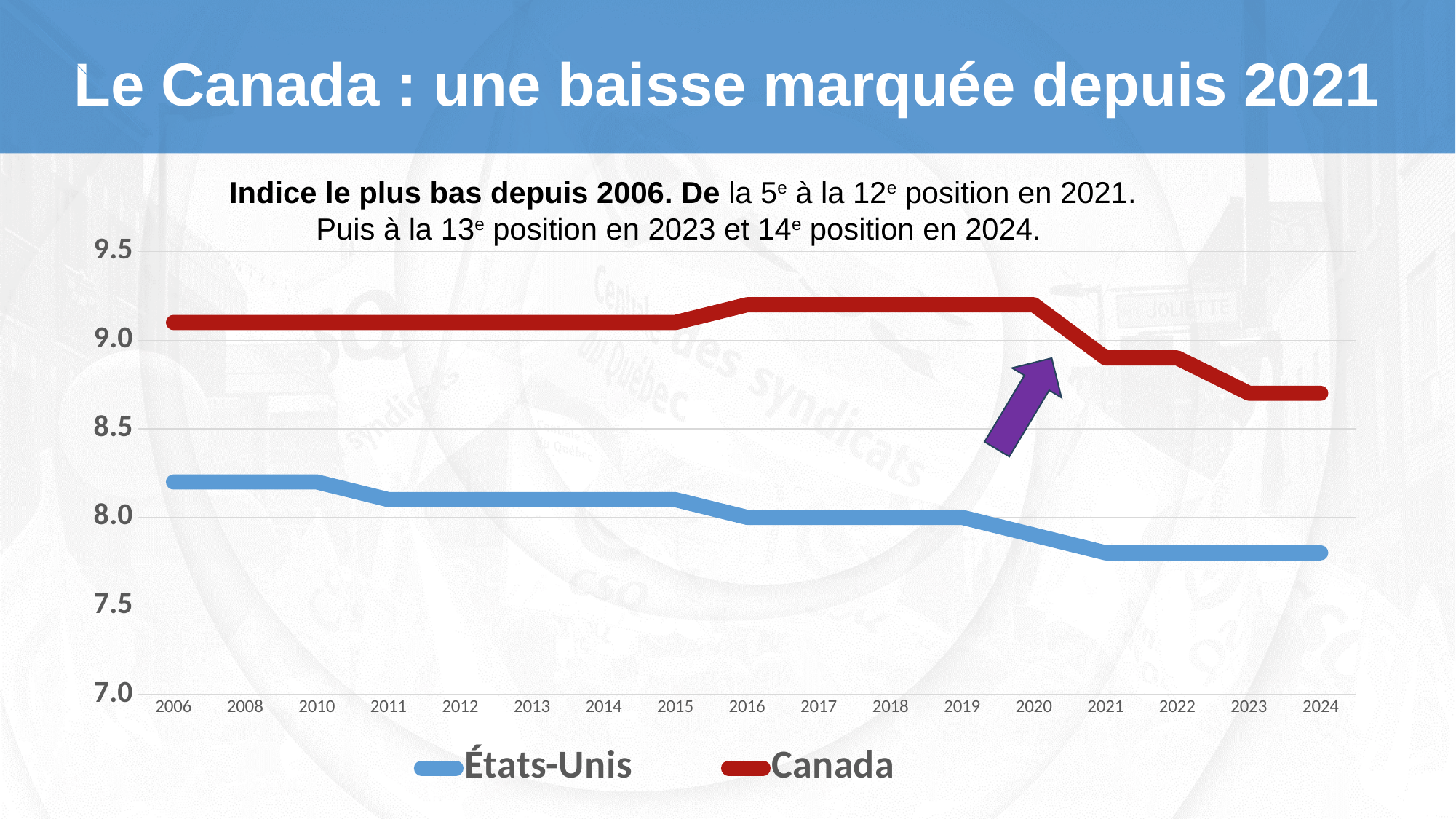
How many years are shown on the x axis? 17 Which series has the higher value in 2024, Canada or États-Unis? Canada Is the value for Canada in 2024 greater or less than 8.5? greater Does the Canada line rise or fall between 2020 and 2024? fall What kind of chart is shown on the slide? line chart Is the value for États-Unis in 2024 greater or less than 8.0? less Is the value for Canada in 2016 greater or less than 9.0? greater How many series does the legend list? 2 What colour is the Canada line in the legend? red Does the États-Unis line rise or fall between 2006 and 2024? fall